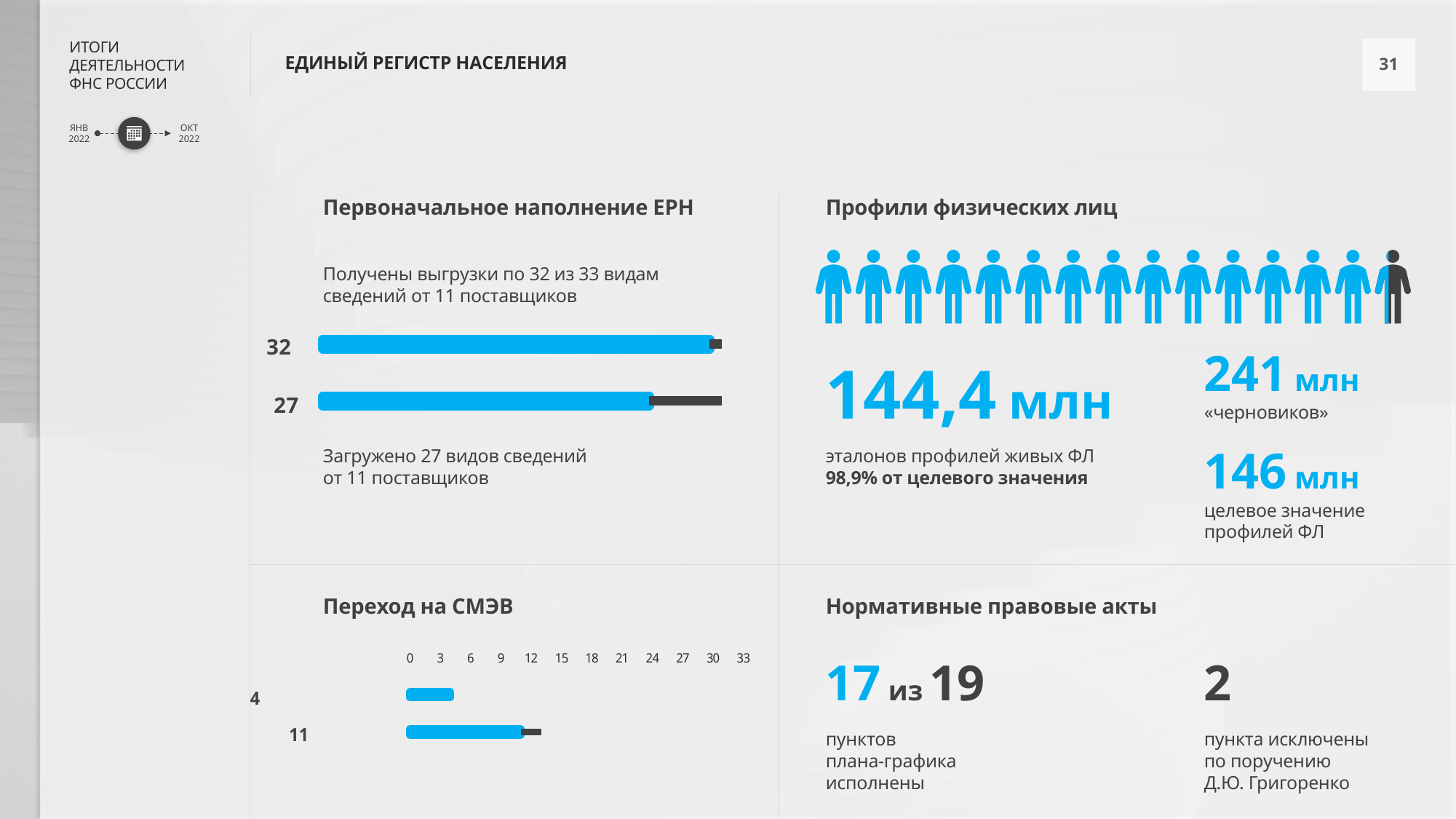
In the "Первоначальное наполнение ЕРН" chart, how many bars are plotted? 2 In the "Первоначальное наполнение ЕРН" chart, what is the difference between the two bar values? 5 What kind of chart is shown under "Первоначальное наполнение ЕРН"? bar chart In the "Переход на СМЭВ" chart, is the value of the top bar greater or less than 6? less In the "Переход на СМЭВ" chart, what is the highest tick shown on the axis? 33 In the "Переход на СМЭВ" chart, what is the value of the bottom bar? 11 In the "Переход на СМЭВ" chart, what is the value of the top bar? 4 In the "Переход на СМЭВ" chart, what is the difference between the two bar values? 7 In the "Первоначальное наполнение ЕРН" chart, what is the value of the bottom bar? 27 In the "Профили физических лиц" pictogram, how many person icons are shown? 15 In the "Первоначальное наполнение ЕРН" chart, what is the value of the top bar? 32